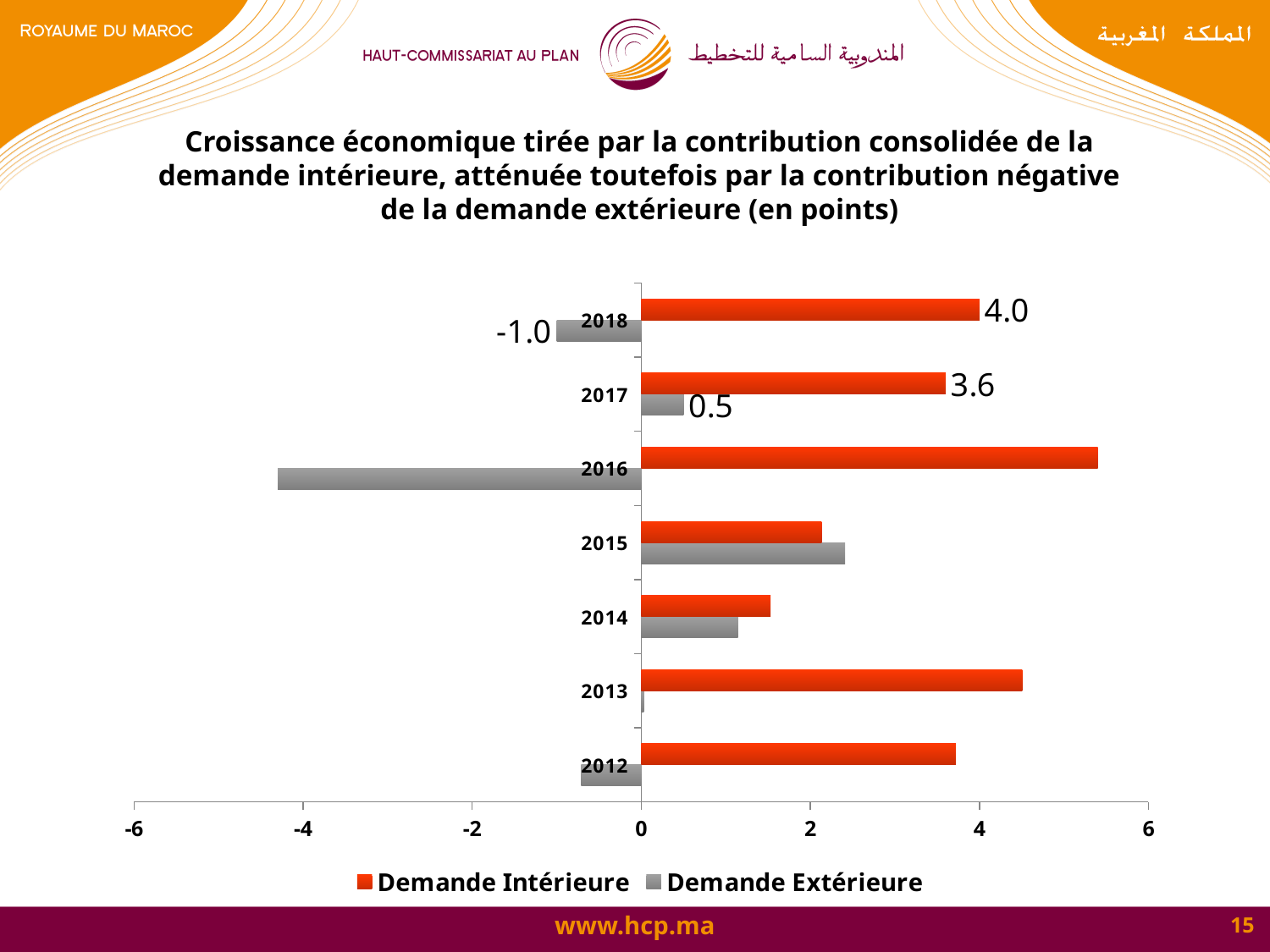
Which year has the lowest value for Demande Extérieure? 2016 By how much did Demande Intérieure change from 2017 to 2018? 0.4 Which year has the highest value for Demande Intérieure? 2016 How many years are shown on the chart? 7 How many series does the legend list? 2 What is the value of Demande Intérieure for 2018? 4.0 Is the value of Demande Intérieure for 2016 greater or less than 4? greater Is the value of Demande Extérieure for 2016 greater or less than -2? less What is the value of Demande Extérieure for 2017? 0.5 What is the value of Demande Extérieure for 2018? -1.0 Which is larger, Demande Intérieure in 2013 or Demande Intérieure in 2012? 2013 What is the value of Demande Intérieure for 2017? 3.6